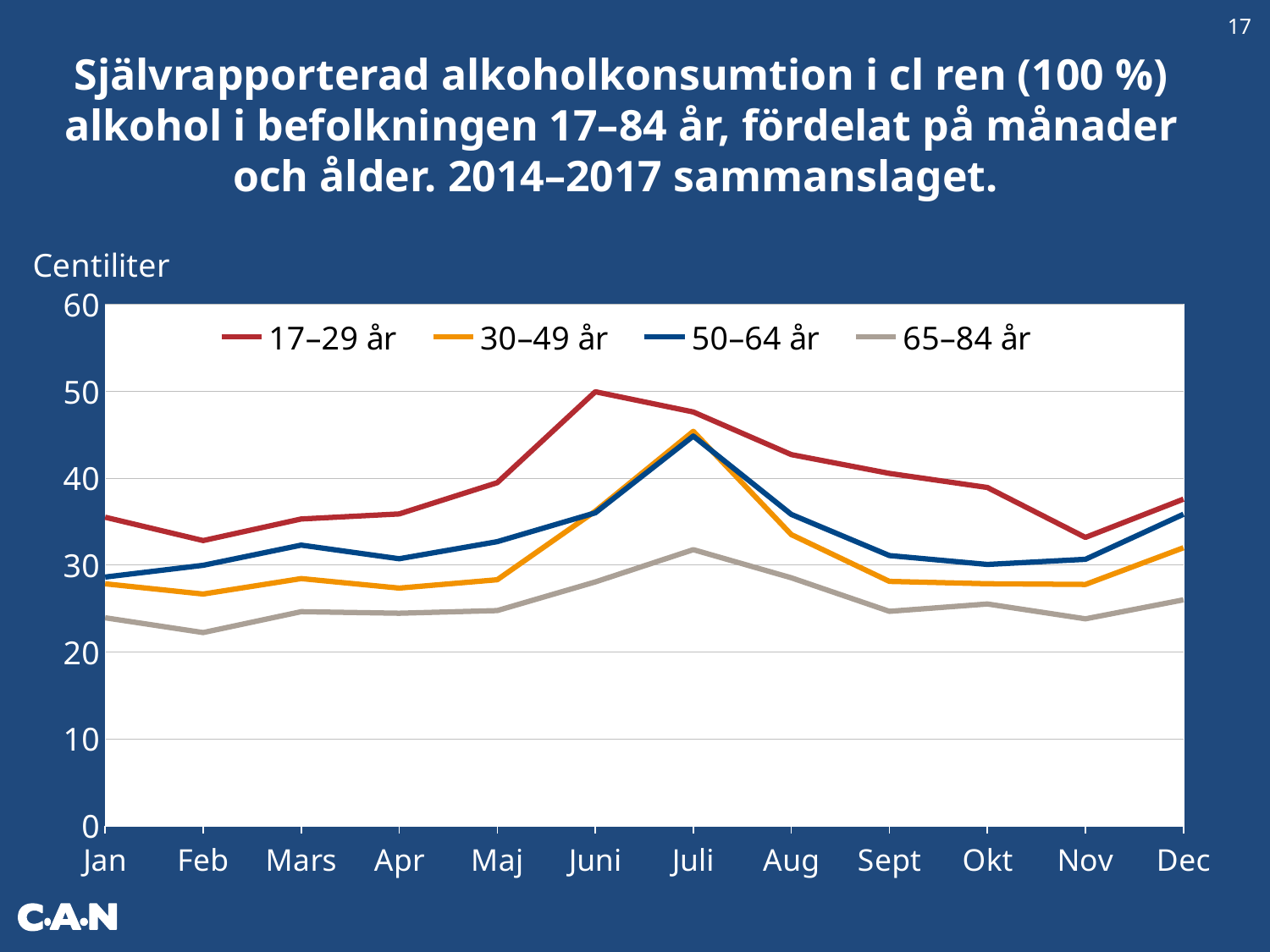
In Jan, which series has the larger value: 17–29 år or 65–84 år? 17–29 år Is the value for 30–49 år in Feb greater or less than 30? less Is the value for 65–84 år in Juli greater or less than 30? greater How many series does the legend list? 4 Is the value for 17–29 år in Juni greater or less than 40? greater How many months are plotted along the x axis? 12 In which month is the 65–84 år series at its lowest? Feb Does the 17–29 år series rise or fall from Juli to Nov? Fall In which month does the 30–49 år series reach its highest value? Juli In Mars, which series has the larger value: 50–64 år or 30–49 år? 50–64 år In which month does the 17–29 år series reach its highest value? Juni What kind of chart is shown on the slide? Line chart